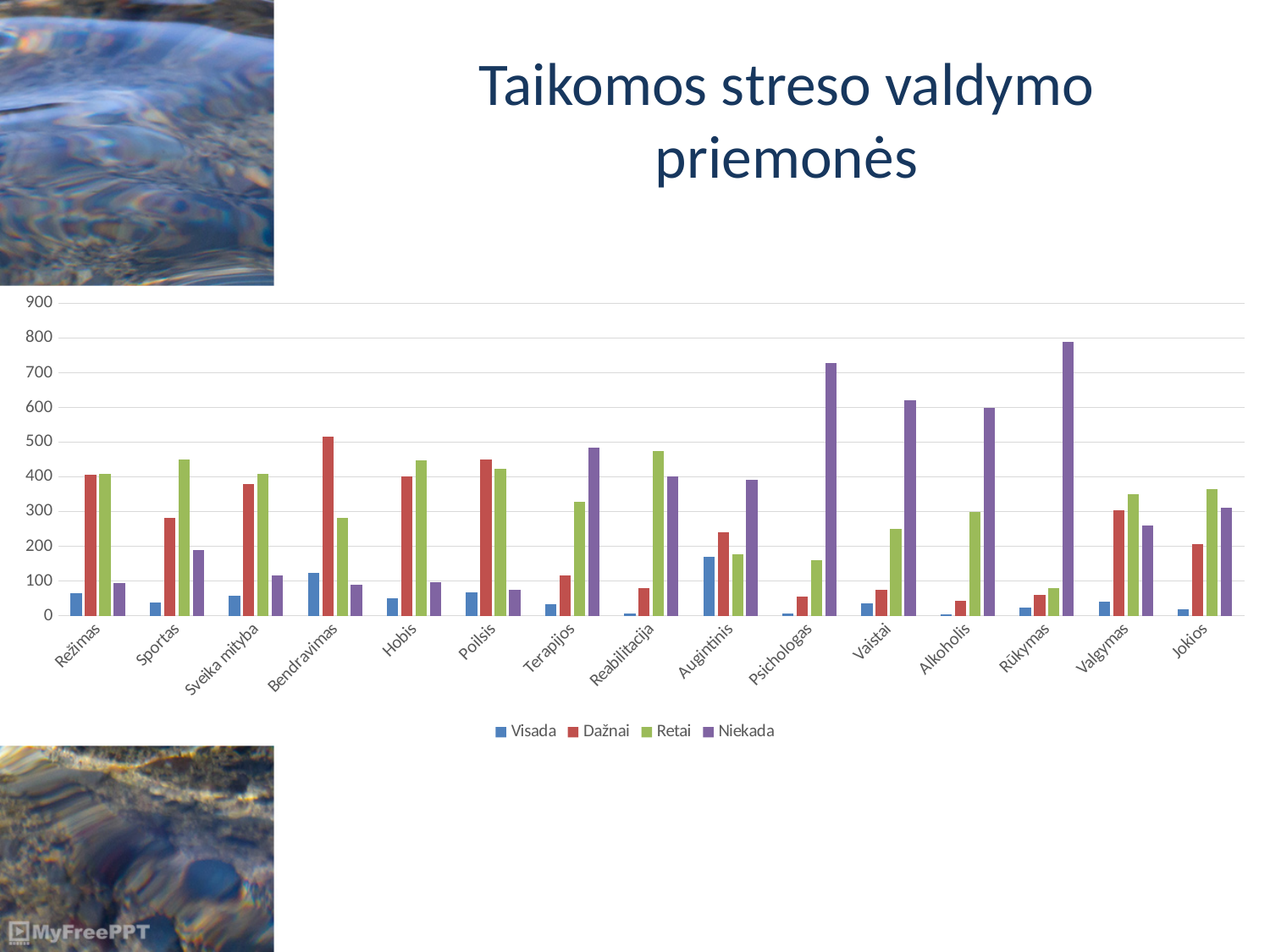
Is the Niekada value for Psichologas greater or less than 700? greater What is the title of the slide containing the chart? Taikomos streso valdymo priemonės How many series does the legend list? 4 Is the Dažnai value for Bendravimas greater or less than 500? greater What kind of chart is shown on the slide? bar chart Which category has the highest Dažnai value? Bendravimas Which category has the highest Niekada value? Rūkymas How many categories are shown on the x axis? 15 Is the Niekada value for Vaistai greater or less than 500? greater Which category has the highest Visada value? Augintinis Which is larger, the Niekada value for Psichologas or for Alkoholis? Psichologas